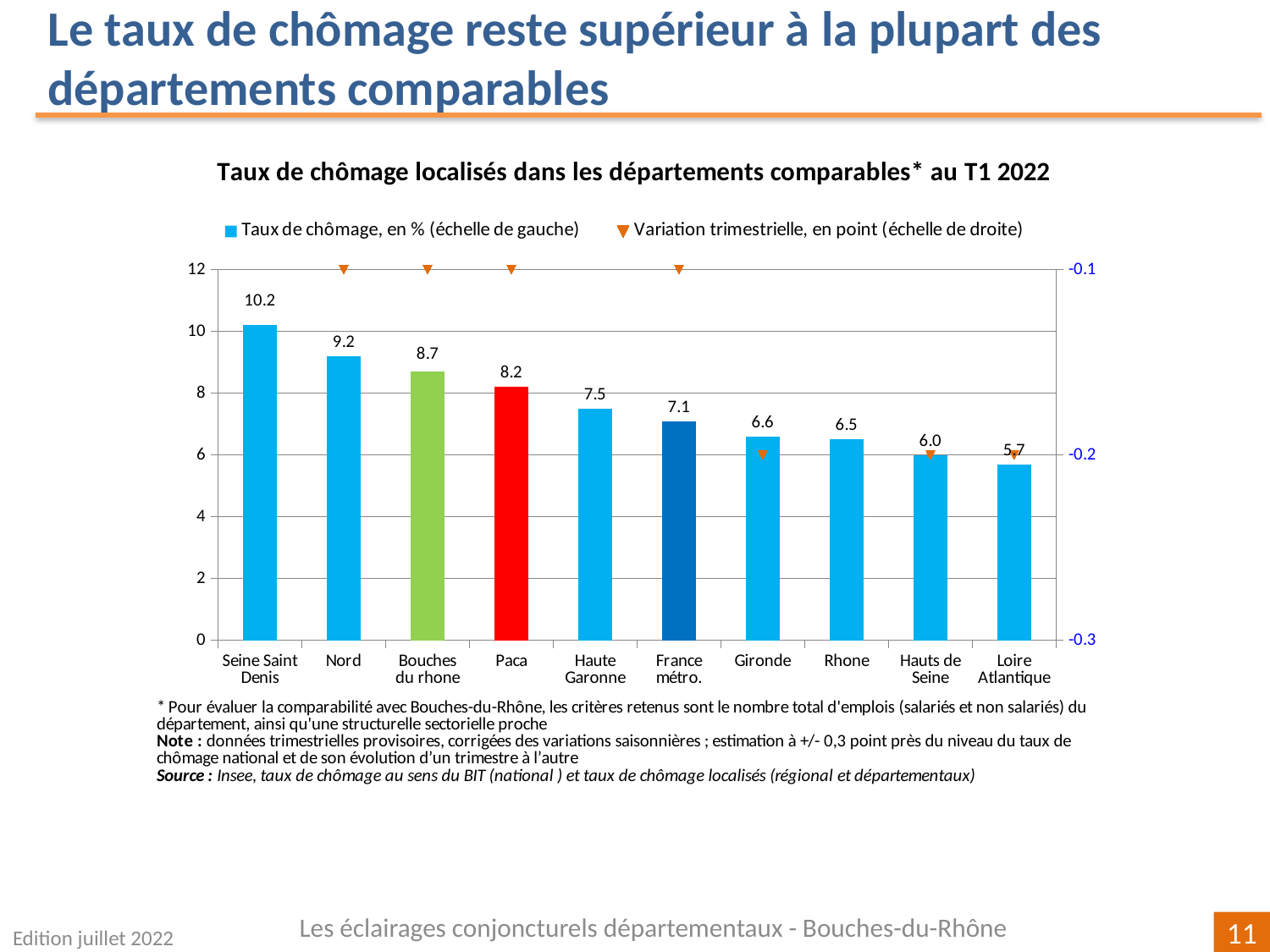
Which department has the highest unemployment rate on the chart? Seine Saint Denis Which has a higher unemployment rate, Nord or Paca? Nord What is the unemployment rate shown for Bouches du rhone? 8.7 What is the unemployment rate (Taux de chômage) shown for Seine Saint Denis? 10.2 What kind of chart is used to show the unemployment rates? Bar chart What is the quarterly variation (Variation trimestrielle) shown for Gironde on the right-hand scale? -0.2 Which department has the lowest unemployment rate on the chart? Loire Atlantique What is the unemployment rate shown for France métro.? 7.1 How many departments or areas are shown on the x axis of the chart? 10 How many series does the legend list? 2 What is the difference between the unemployment rates of Seine Saint Denis and Bouches du rhone? 1.5 Do the unemployment rate bars rise or fall from left to right along the x axis? Fall